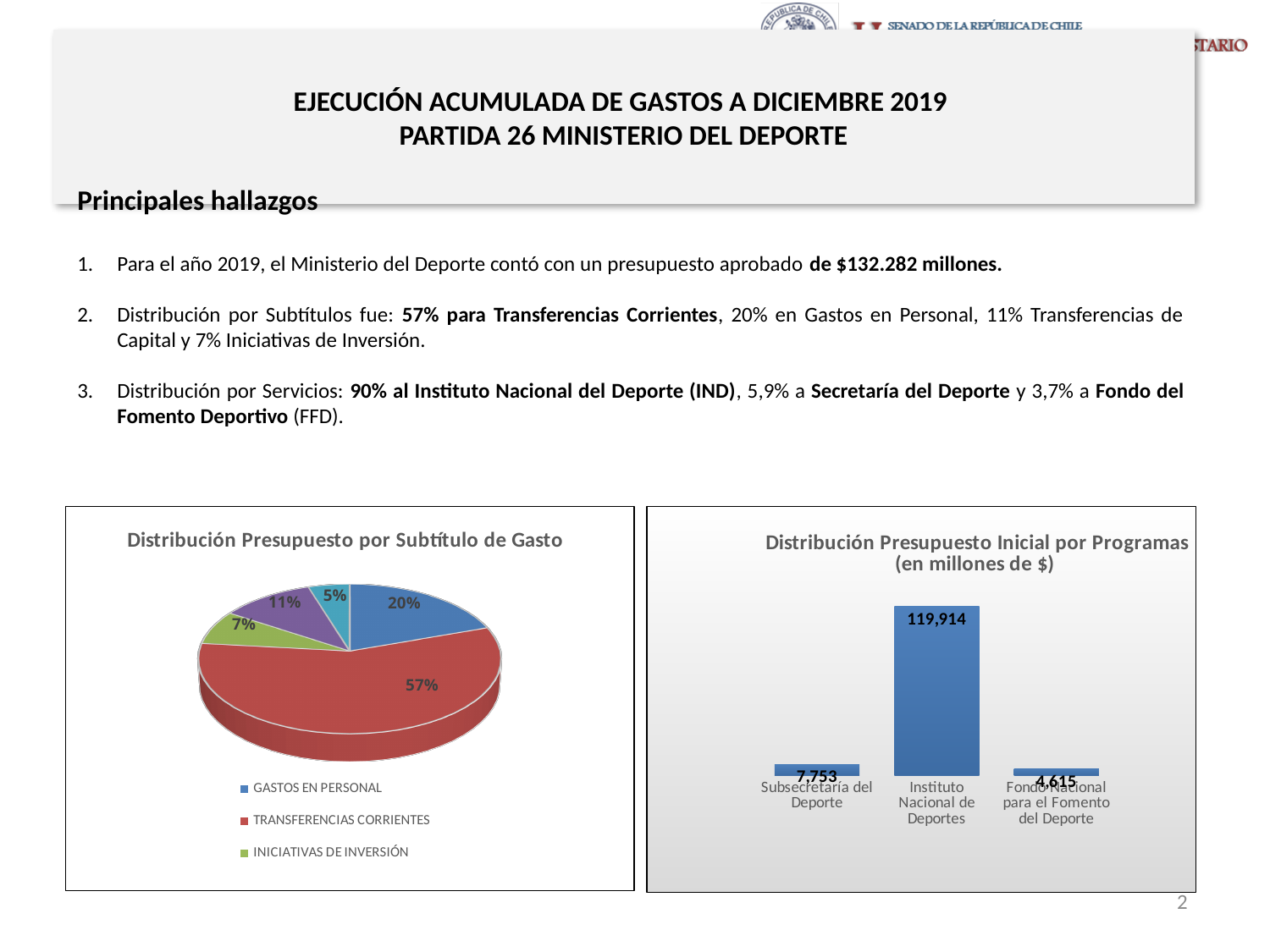
In the chart 'Distribución Presupuesto Inicial por Programas', what is the value for Instituto Nacional de Deportes? 119,914 How many entries does the legend of the pie chart 'Distribución Presupuesto por Subtítulo de Gasto' list? 3 In the chart 'Distribución Presupuesto Inicial por Programas', what is the value for Subsecretaría del Deporte? 7,753 In the pie chart 'Distribución Presupuesto por Subtítulo de Gasto', what share does TRANSFERENCIAS CORRIENTES have? 57% In the pie chart 'Distribución Presupuesto por Subtítulo de Gasto', which category has the largest slice? TRANSFERENCIAS CORRIENTES In the chart 'Distribución Presupuesto Inicial por Programas', what is the value for Fondo Nacional para el Fomento del Deporte? 4,615 In the pie chart 'Distribución Presupuesto por Subtítulo de Gasto', what share does GASTOS EN PERSONAL have? 20% In the pie chart 'Distribución Presupuesto por Subtítulo de Gasto', what share does INICIATIVAS DE INVERSIÓN have? 7% In the chart 'Distribución Presupuesto Inicial por Programas', how many programs are shown? 3 In the chart 'Distribución Presupuesto Inicial por Programas', which program has the lowest value? Fondo Nacional para el Fomento del Deporte What type of chart is 'Distribución Presupuesto Inicial por Programas'? Bar chart In the chart 'Distribución Presupuesto Inicial por Programas', what is the difference between Instituto Nacional de Deportes and Subsecretaría del Deporte? 112,161